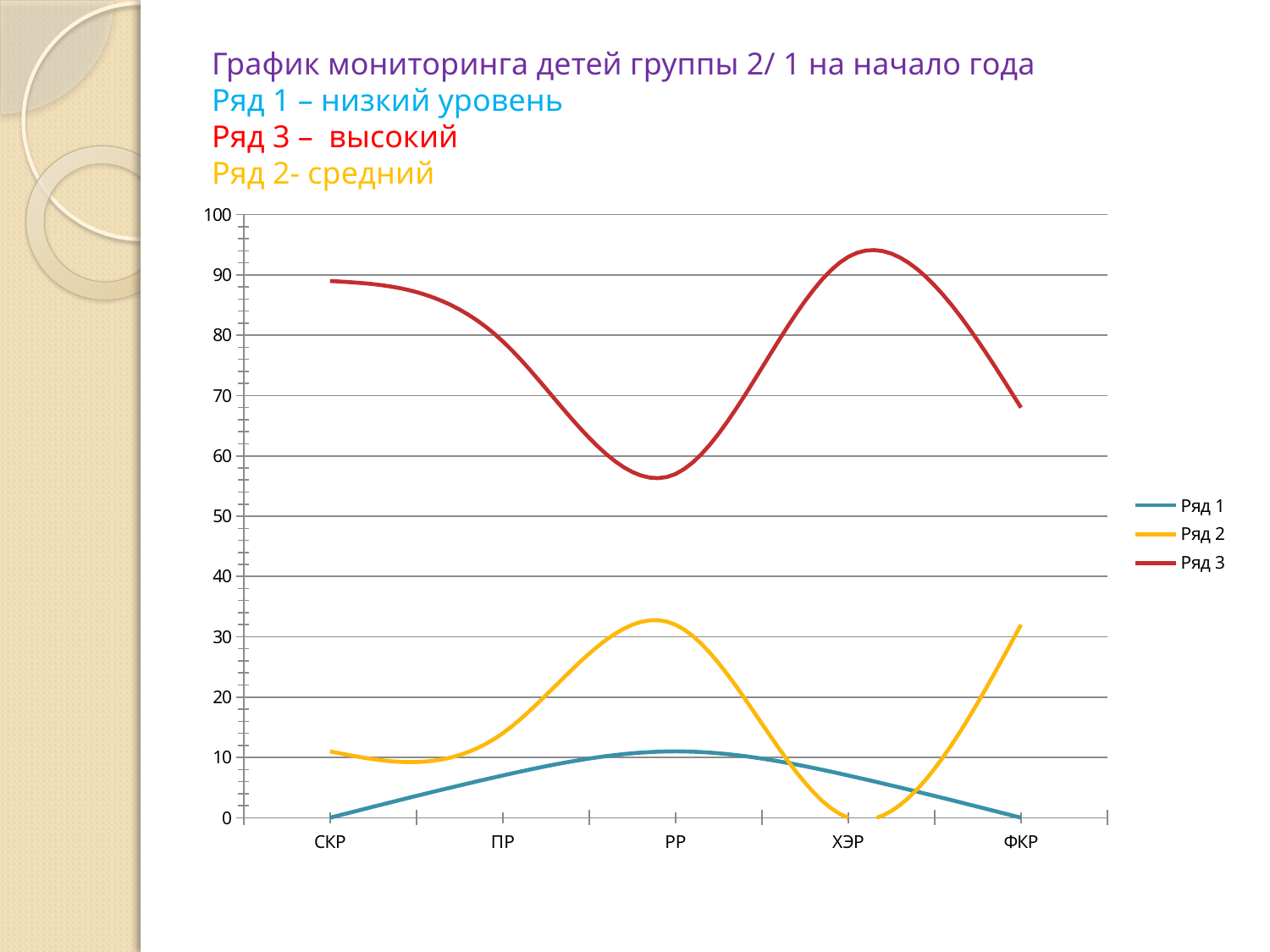
How many categories are shown on the x axis? 5 For Ряд 3, which category has the lowest value? РР What kind of chart is shown on the slide? line chart Is the value of Ряд 3 for РР greater or less than 60? less Is the value of Ряд 2 for РР greater or less than 20? greater How many series does the legend list? 3 According to the slide text, which series represents the high level (высокий)? Ряд 3 For Ряд 3, which category has the highest value? ХЭР What is the value of Ряд 1 for СКР? 0 For Ряд 2, which category has the lowest value? ХЭР At ФКР, which series has the larger value, Ряд 1 or Ряд 2? Ряд 2 Is the value of Ряд 3 for СКР greater or less than 80? greater